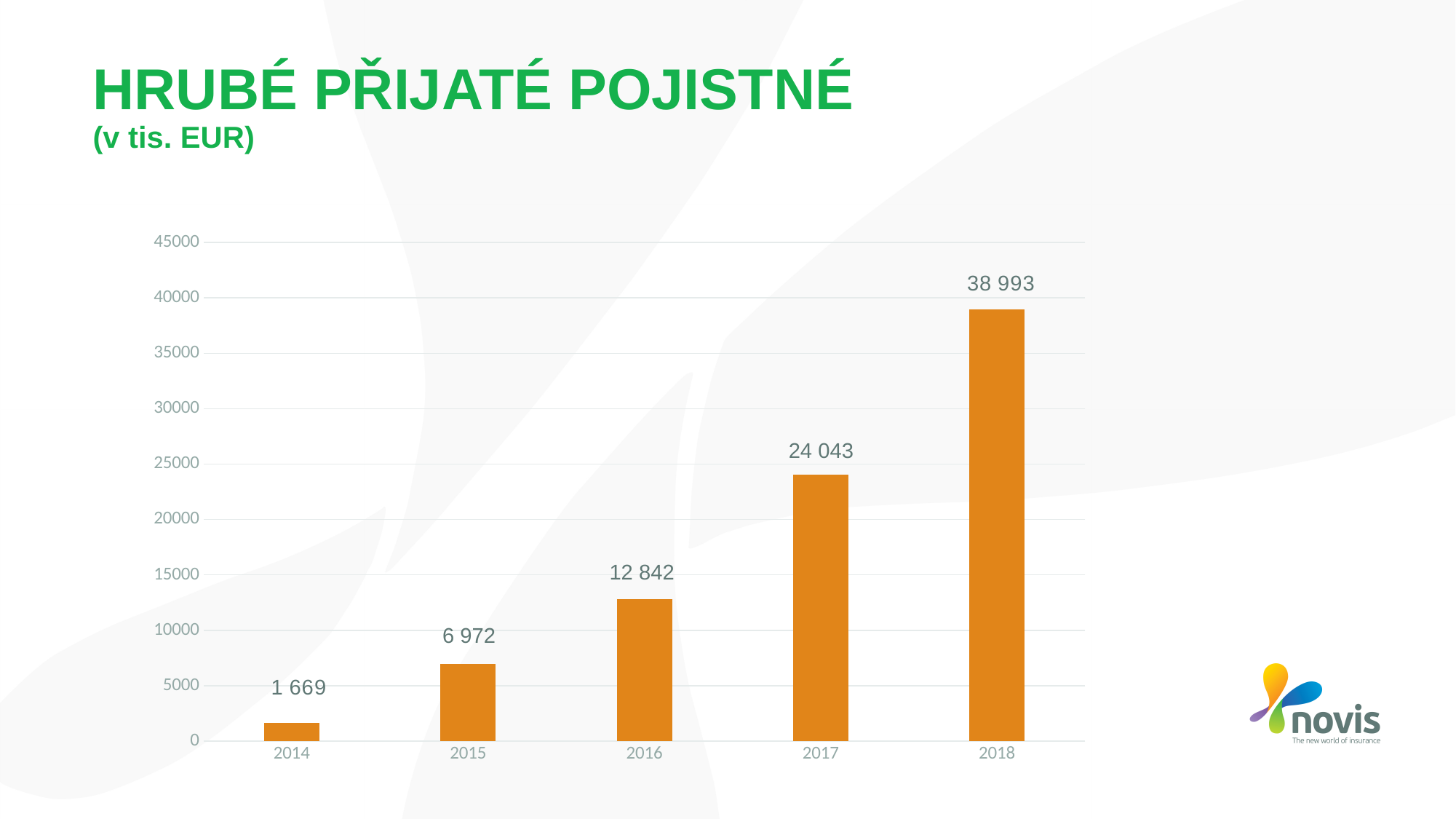
What is the value for 2014? 1 669 What is the value for 2016? 12 842 What is the difference between the values for 2018 and 2017? 14 950 Is the value for 2017 greater or less than 20000? greater Which year has the highest value? 2018 Do the values rise or fall from 2014 to 2018? rise What is the difference between the values for 2016 and 2015? 5 870 Which is larger, the value for 2017 or the value for 2016? 2017 How many years are shown on the x axis? 5 Which year has the lowest value? 2014 What is the value for 2018? 38 993 What kind of chart is shown on the slide? bar chart